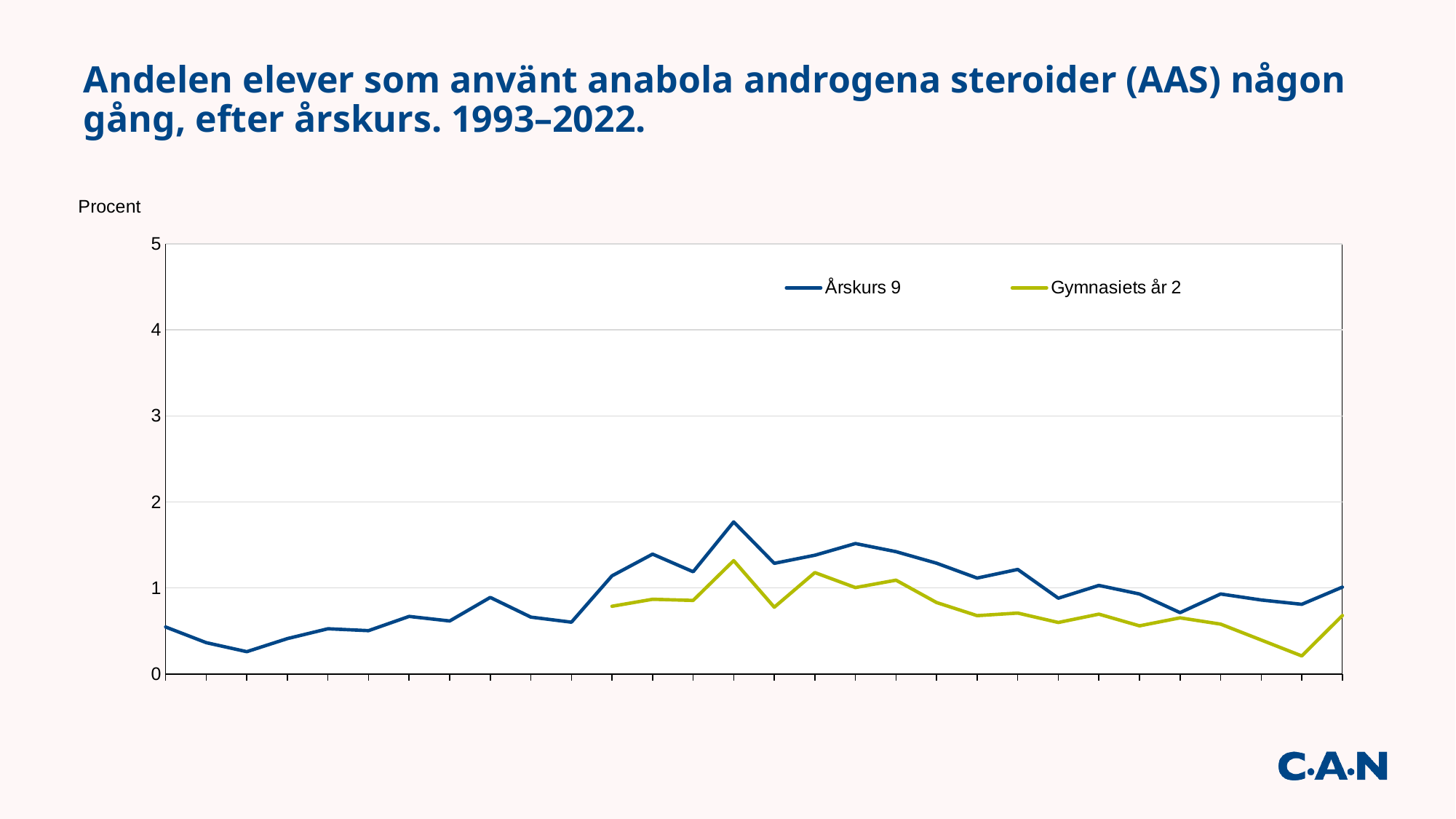
Comparing its first and last points, does the Årskurs 9 line rise or fall overall across the chart? rise What is the label on the vertical axis of the chart? Procent Is the highest value of the Årskurs 9 line greater or less than 1? greater Is the highest value of the Årskurs 9 line greater or less than 2? less Is the lowest value of the Gymnasiets år 2 line greater or less than 1? less How many series does the legend list? 2 What kind of chart is shown on the slide? line chart Which series is higher at the peak where both lines rise sharply in the middle of the chart, Årskurs 9 or Gymnasiets år 2? Årskurs 9 Which series reaches the highest point on the chart? Årskurs 9 What are the two series named in the legend? Årskurs 9 and Gymnasiets år 2